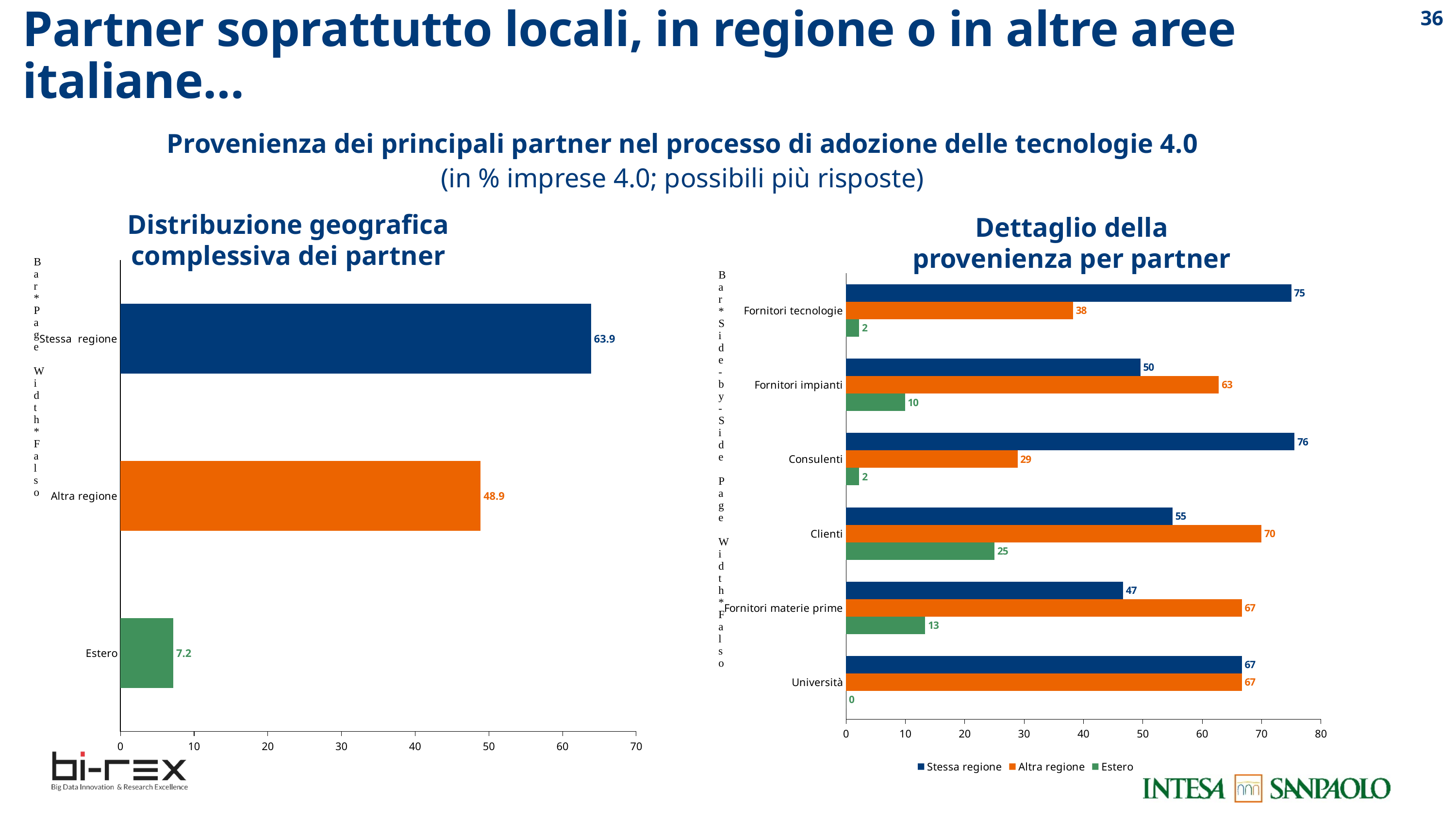
What kind of chart is 'Distribuzione geografica complessiva dei partner'? Bar chart In the 'Dettaglio della provenienza per partner' chart, what is the Altra regione value for Fornitori impianti? 63 In the 'Distribuzione geografica complessiva dei partner' chart, how many categories are shown? 3 In the 'Dettaglio della provenienza per partner' chart, what is the difference between the Altra regione and Stessa regione values for Clienti? 15 In the 'Dettaglio della provenienza per partner' chart, what is the Estero value for Clienti? 25 In the 'Dettaglio della provenienza per partner' chart, which partner has the highest Stessa regione value? Consulenti In the 'Distribuzione geografica complessiva dei partner' chart, which category has the lowest value? Estero In the 'Distribuzione geografica complessiva dei partner' chart, what is the difference between Stessa regione and Altra regione? 15.0 How many series does the legend of the 'Dettaglio della provenienza per partner' chart list? 3 In the 'Dettaglio della provenienza per partner' chart, which partner has the lowest Estero value? Università In the 'Dettaglio della provenienza per partner' chart, is the Stessa regione value for Fornitori tecnologie larger or the Altra regione value? Stessa regione In the 'Distribuzione geografica complessiva dei partner' chart, what is the value for Stessa regione? 63.9